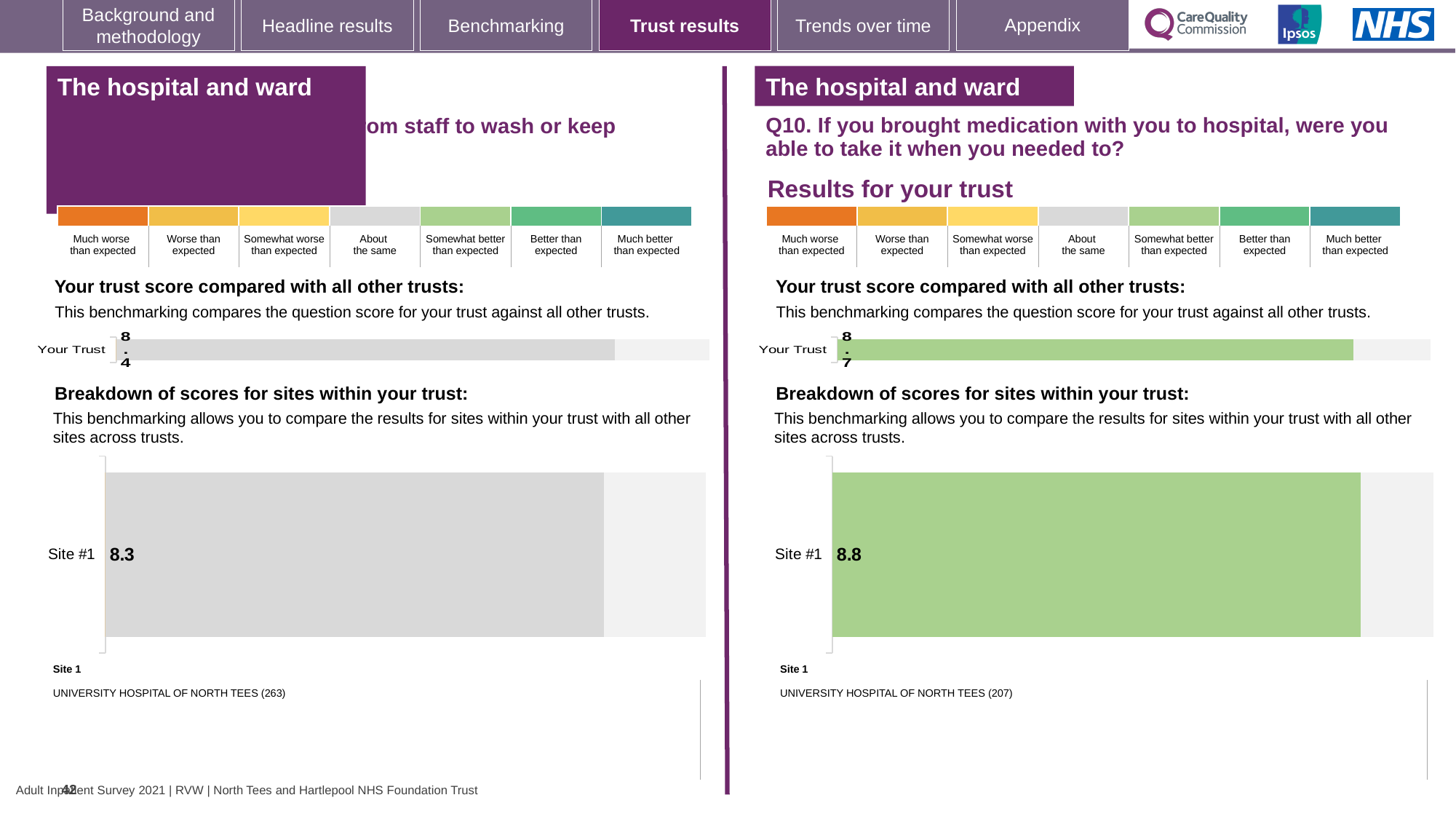
On the right-hand side of the slide (Q10), what is the score shown for Site #1? 8.8 On the right-hand side of the slide (Q10), what is the score shown for Your Trust? 8.7 On the right-hand side of the slide (Q10), which benchmark category does the green colour of the Site #1 bar correspond to in the legend? Somewhat better than expected What type of chart is used to show the Site #1 score on the right-hand side of the slide (Q10)? Bar chart On the right-hand side of the slide (Q10), which is larger: the Your Trust score or the Site #1 score? Site #1 What is the difference between the Your Trust score on the right-hand side (Q10) and the Your Trust score on the left-hand side of the slide? 0.3 On the left-hand side of the slide, what is the score shown for Site #1? 8.3 On the left-hand side of the slide, what is the score shown for Your Trust? 8.4 What is the difference between the Site #1 score on the right-hand side (Q10) and the Site #1 score on the left-hand side of the slide? 0.5 How many sites are shown in the breakdown of scores chart on the right-hand side of the slide (Q10)? 1 On the left-hand side of the slide, which is larger: the Your Trust score or the Site #1 score? Your Trust On the left-hand side of the slide, which benchmark category does the grey colour of the Site #1 bar correspond to in the legend? About the same